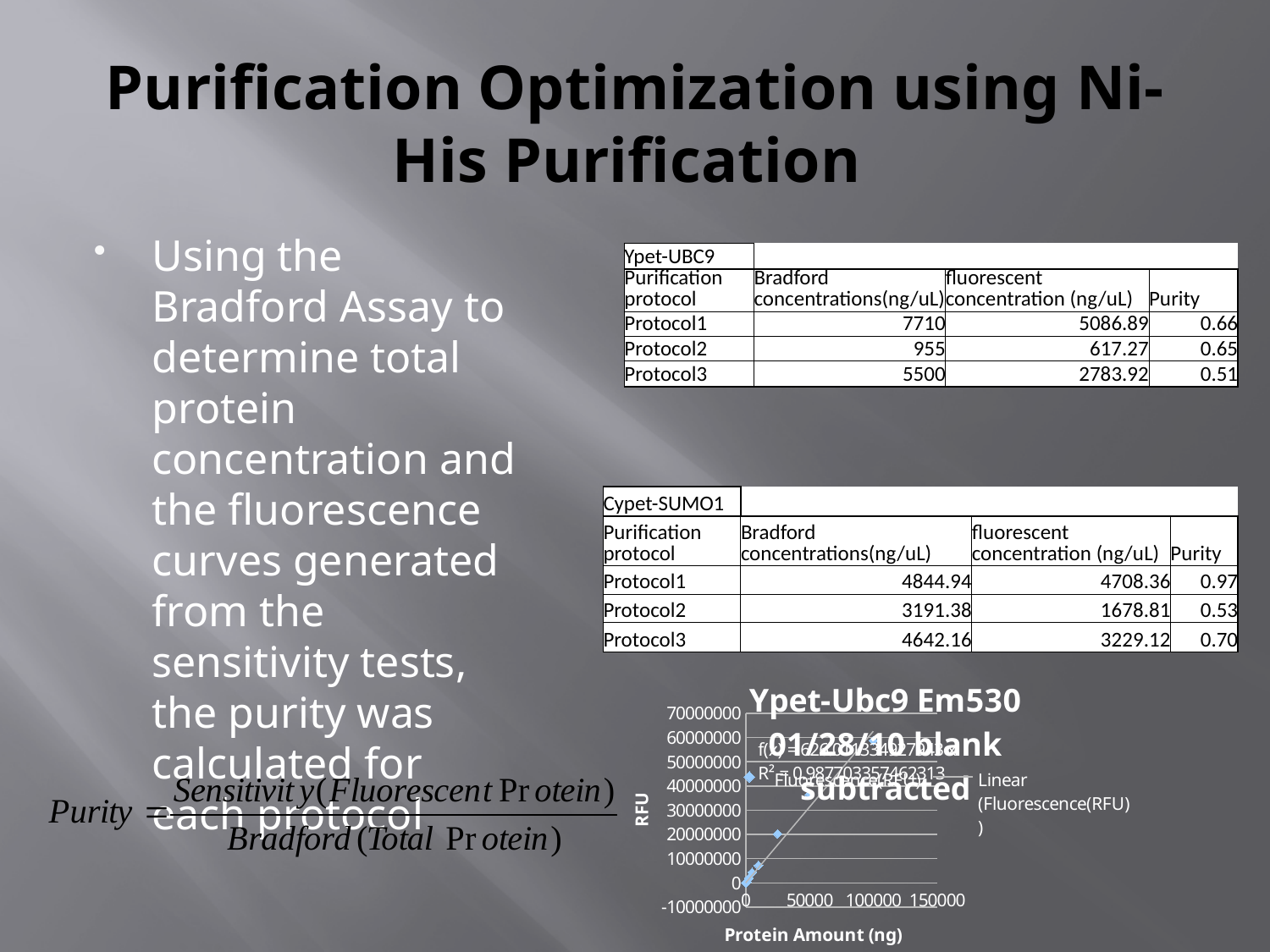
What is the label of the chart's x axis? Protein Amount (ng) What is the highest tick value shown on the chart's x axis? 150000 What is the highest tick value shown on the chart's y axis? 70000000 What kind of chart is shown on the slide? scatter chart Do the plotted RFU values rise or fall as Protein Amount (ng) increases? rise What is the title of the chart on the slide? Ypet-Ubc9 Em530 01/28/10 blank subtracted How many entries does the chart's legend list? 2